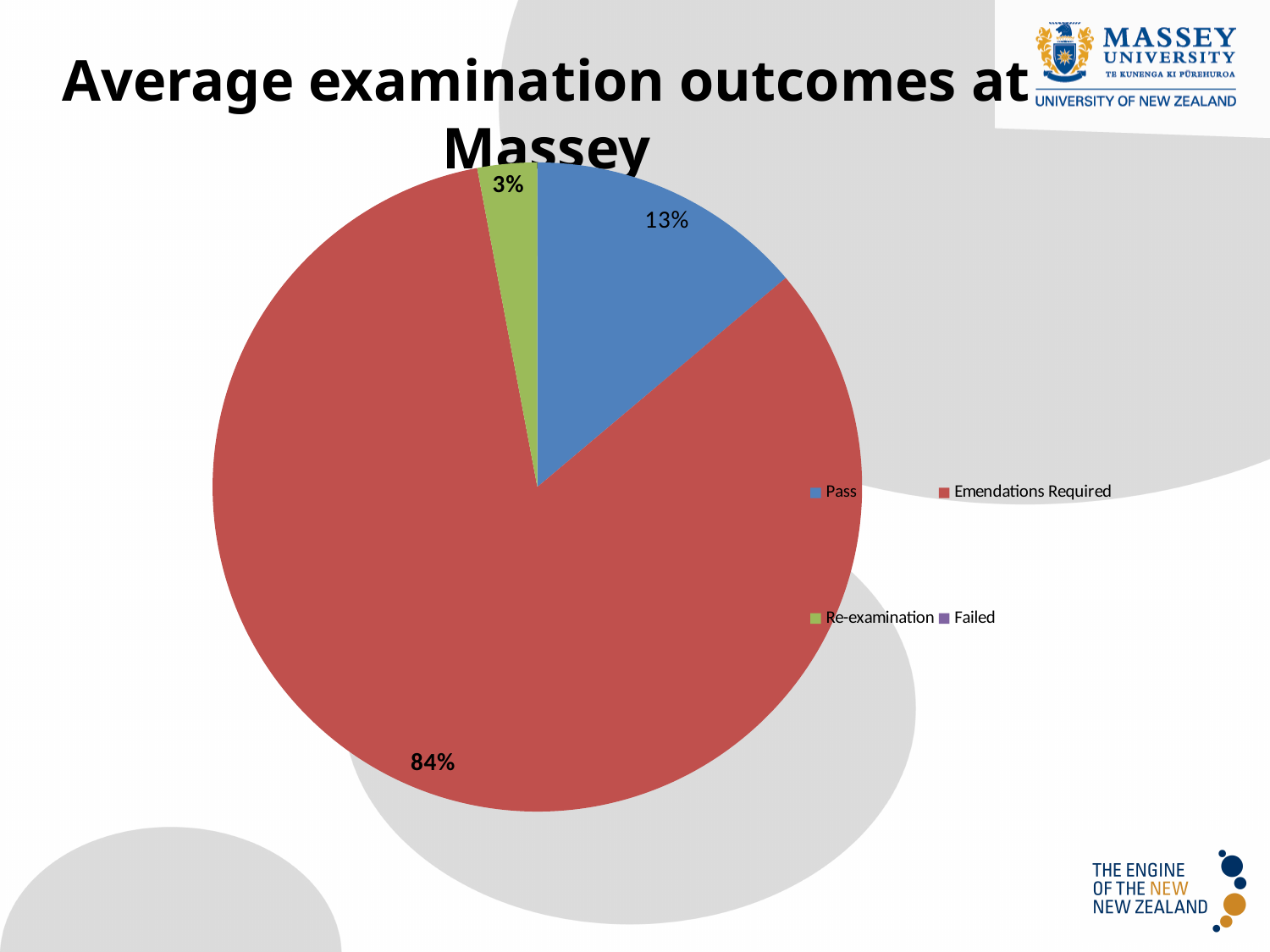
What is the title of the slide containing the chart? Average examination outcomes at Massey What percentage of examination outcomes is labelled Emendations Required? 84% What percentage of examination outcomes is labelled Re-examination? 3% How many outcome categories does the legend list? 4 What percentage of examination outcomes is labelled Pass? 13% Which is larger, the Pass share or the Re-examination share? Pass How many percentage points larger is the Emendations Required share than the Pass share? 71 percentage points Which labelled slice has the smallest share of the pie? Re-examination What colour is the Emendations Required slice? Red What kind of chart is shown on the slide? Pie chart Which outcome has the largest share of the pie? Emendations Required What is the combined share of the Pass and Re-examination slices? 16%